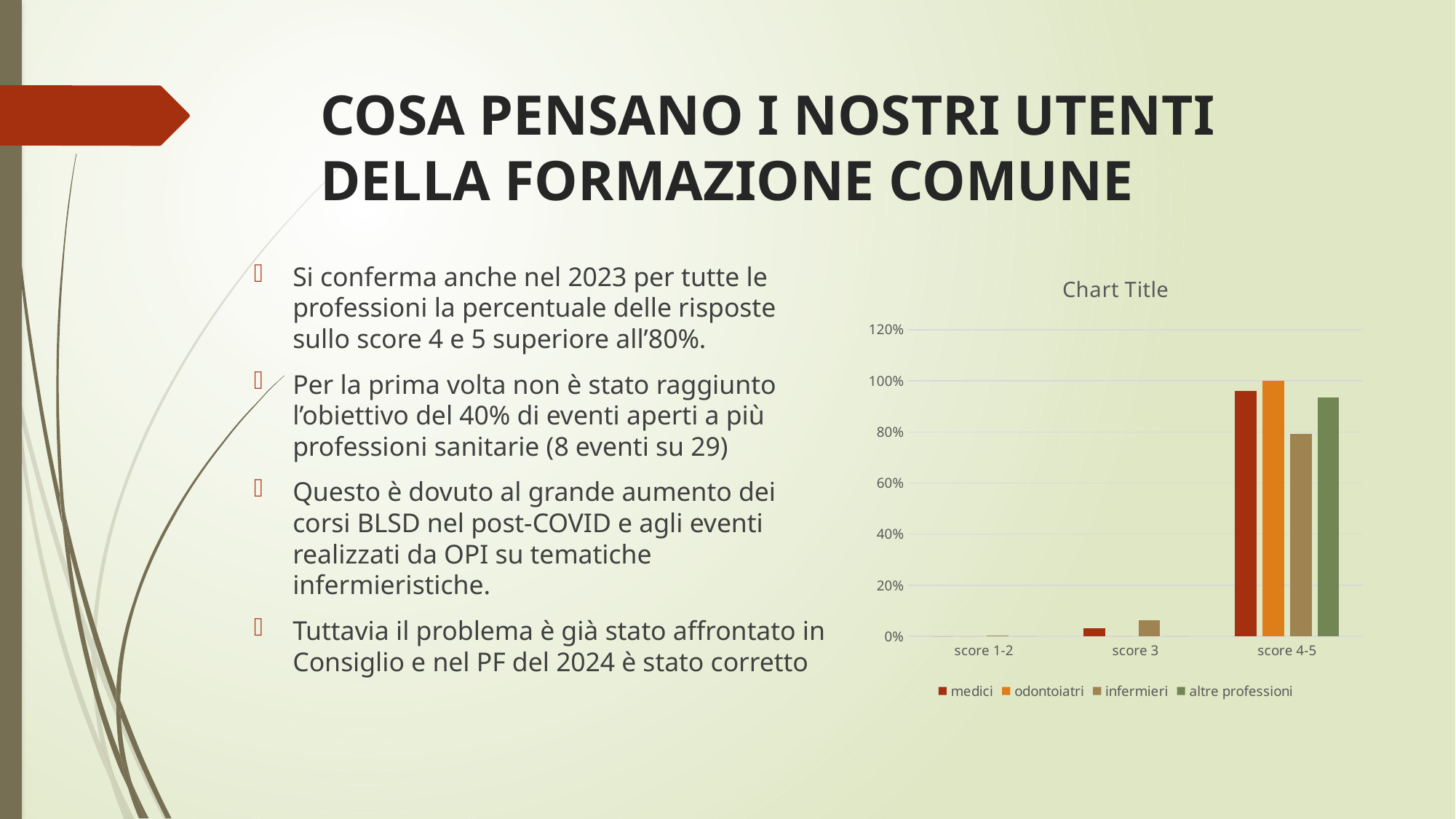
In the score 4-5 category, which is larger: the value for medici or the value for infermieri? medici What is the value for odontoiatri in the score 4-5 category? 100% Is the value for medici in the score 4-5 category greater or less than 80%? greater What is the title of the chart? Chart Title Which series has the lowest value in the score 4-5 category? infermieri How many series does the chart legend list? 4 Is the value for infermieri in the score 4-5 category greater or less than 60%? greater Is the value for altre professioni in the score 4-5 category greater or less than 80%? greater Which series has the highest value in the score 4-5 category? odontoiatri Do the values for medici rise or fall from score 1-2 to score 4-5? rise How many categories are shown on the x axis of the chart? 3 What kind of chart is shown on the slide? bar chart